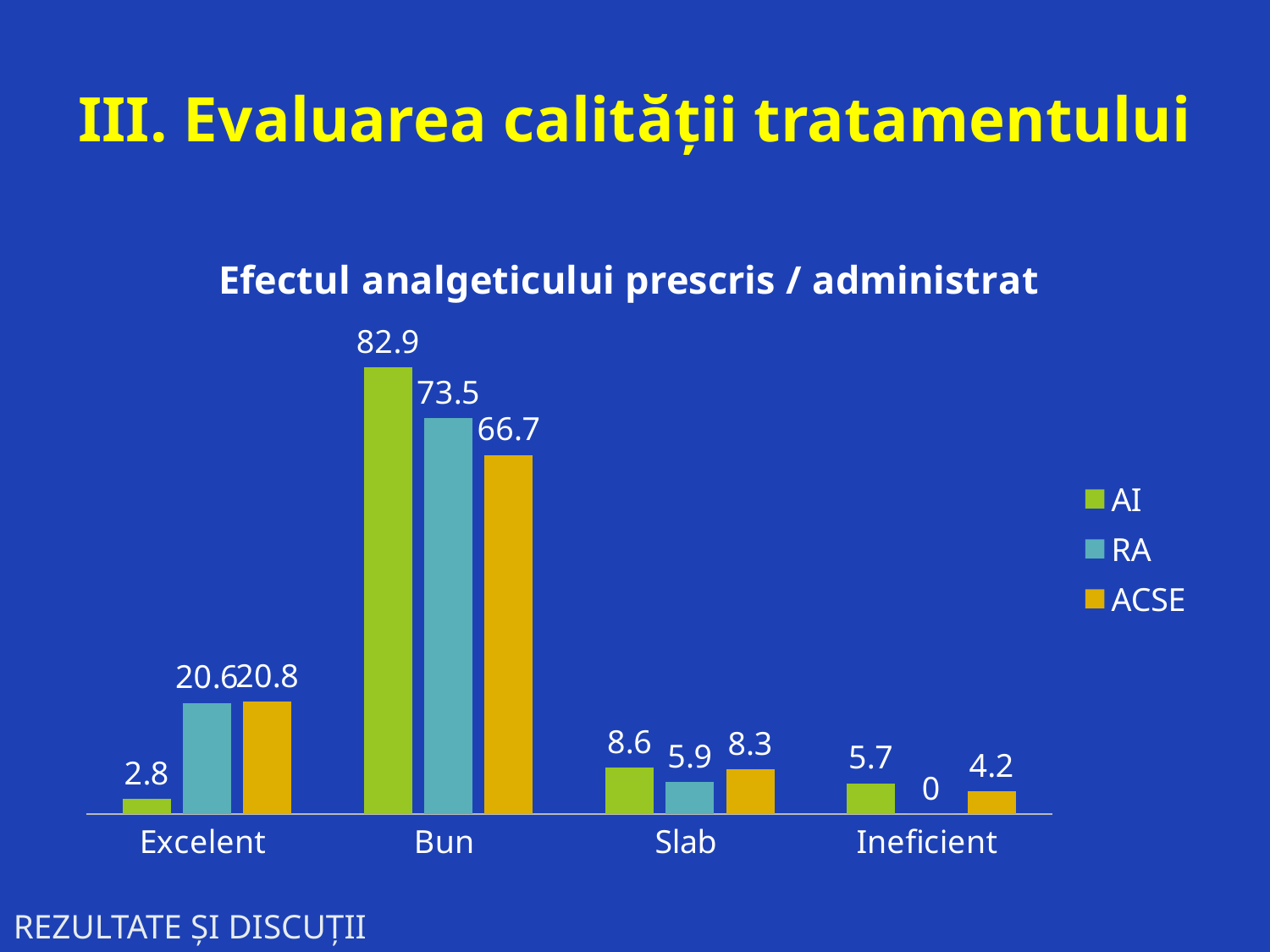
What is the value for AI in the Excelent category? 2.8 What is the value for ACSE in the Bun category? 66.7 What is the value for AI in the Bun category? 82.9 Which category has the highest value for the AI series? Bun How many series does the legend list? 3 Which category has the lowest value for the RA series? Ineficient What is the value for ACSE in the Slab category? 8.3 What kind of chart is shown on the slide? Bar chart What is the difference between the AI and ACSE values in the Bun category? 16.2 What is the value for RA in the Bun category? 73.5 What is the value for RA in the Ineficient category? 0 In the Slab category, which is larger: the AI value or the RA value? AI